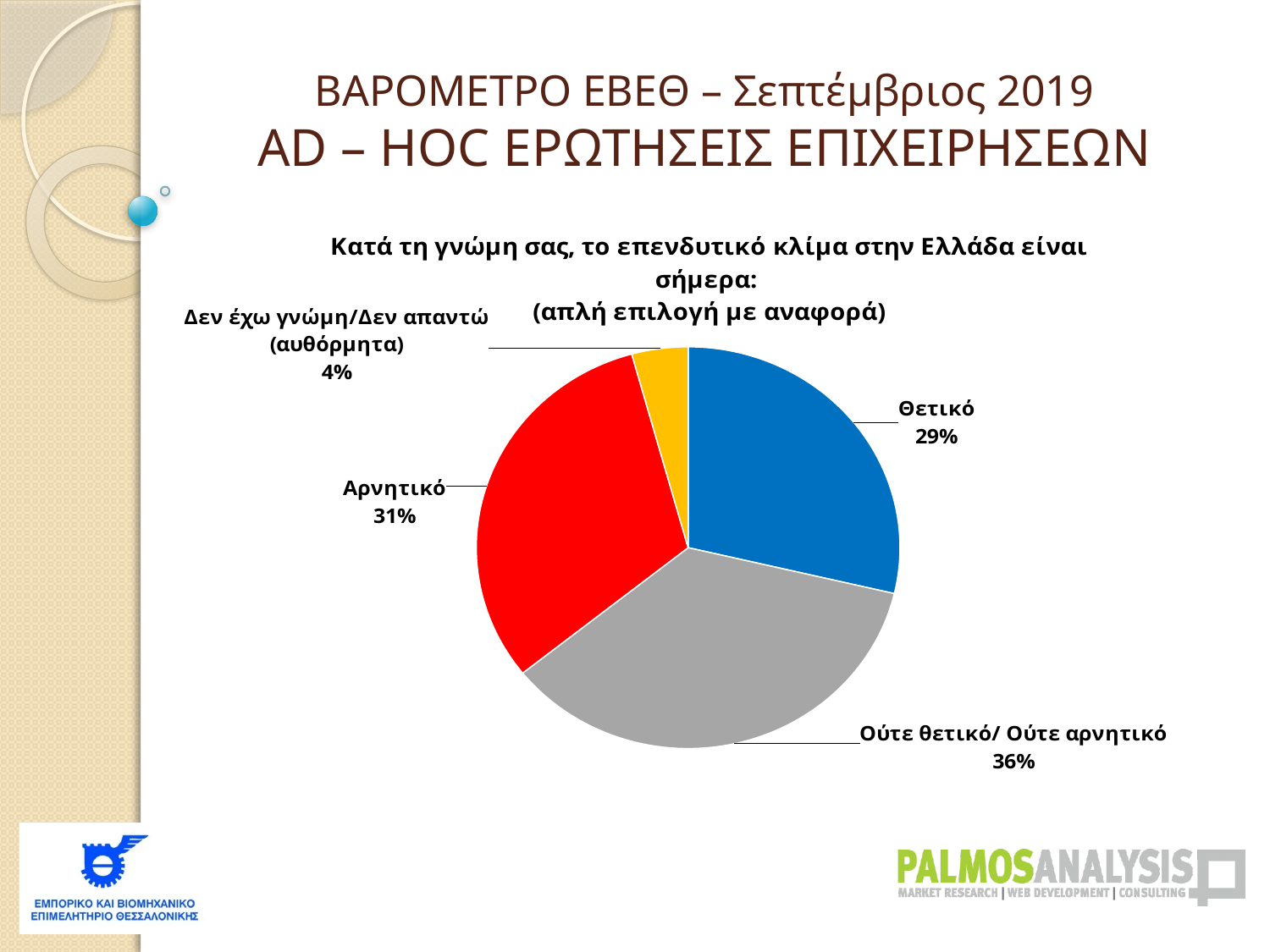
What is the difference in percentage points between Αρνητικό and Θετικό? 2 What percentage of respondents answered Θετικό? 29% What is the difference in percentage points between Ούτε θετικό/ Ούτε αρνητικό and Θετικό? 7 What kind of chart is shown on the slide? pie chart What percentage of respondents answered Ούτε θετικό/ Ούτε αρνητικό? 36% Which is larger, the share for Αρνητικό or the share for Δεν έχω γνώμη/Δεν απαντώ (αυθόρμητα)? Αρνητικό What percentage of respondents answered Δεν έχω γνώμη/Δεν απαντώ (αυθόρμητα)? 4% Which response has the largest share of the pie? Ούτε θετικό/ Ούτε αρνητικό How many slices does the pie chart have? 4 What colour is the slice for Ούτε θετικό/ Ούτε αρνητικό? grey What percentage of respondents answered Αρνητικό? 31% Which response has the smallest share of the pie? Δεν έχω γνώμη/Δεν απαντώ (αυθόρμητα)